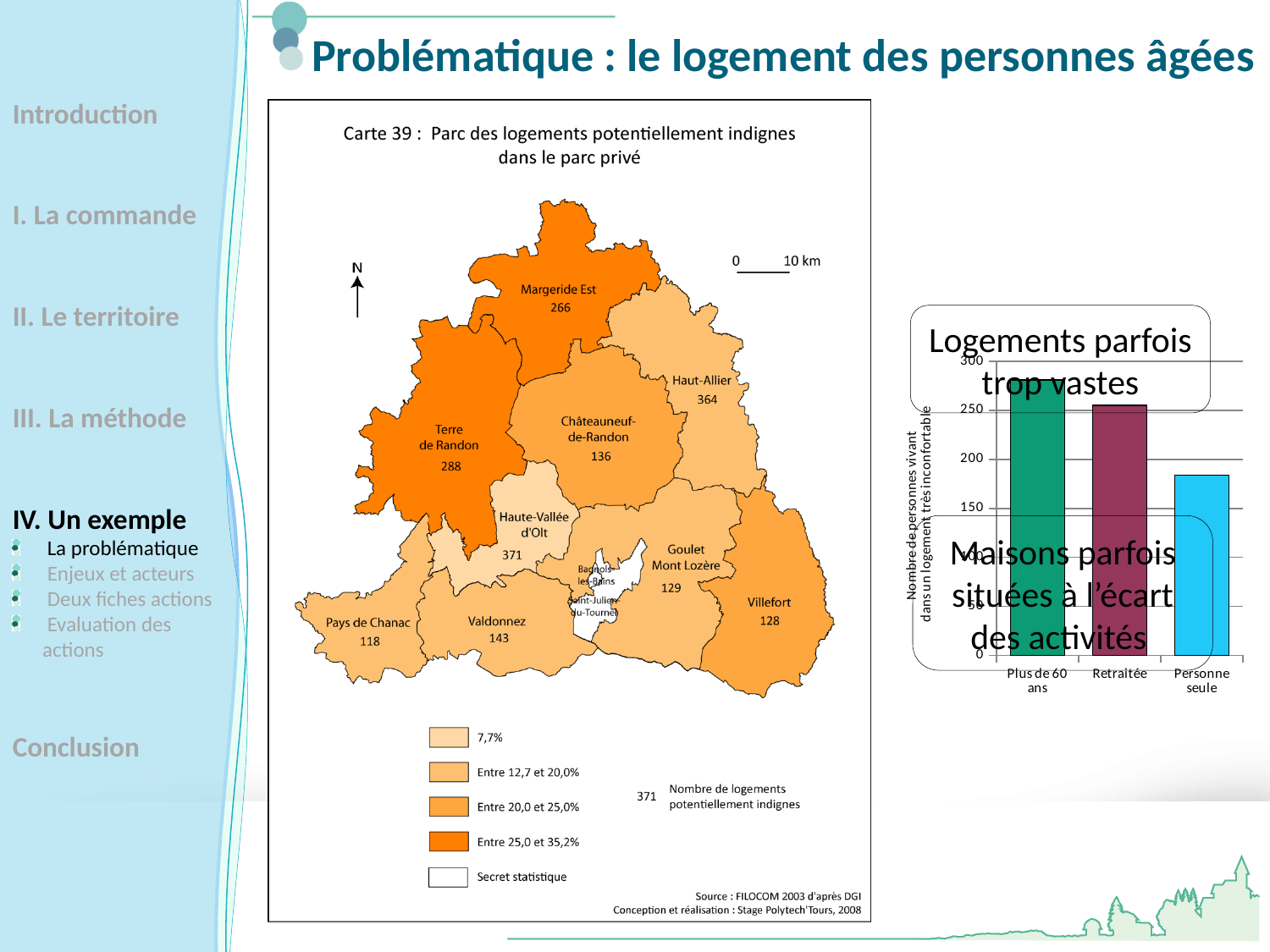
What is the label of the y axis of the bar chart? Nombre de personnes vivant dans un logement très inconfortable In the bar chart, is the value for Retraitée greater or less than 200? greater In the bar chart, is the value for Personne seule greater or less than 200? less Which category has the highest bar in the bar chart? Plus de 60 ans In the bar chart, is the value for Personne seule greater or less than 150? greater How many categories are shown on the x axis of the bar chart? 3 In the bar chart, which is larger: the value for Retraitée or the value for Personne seule? Retraitée What kind of chart is shown on the right side of the slide? bar chart What colour is the bar for Personne seule in the bar chart? light blue In the bar chart, which is larger: the value for Plus de 60 ans or the value for Personne seule? Plus de 60 ans Which category has the lowest bar in the bar chart? Personne seule